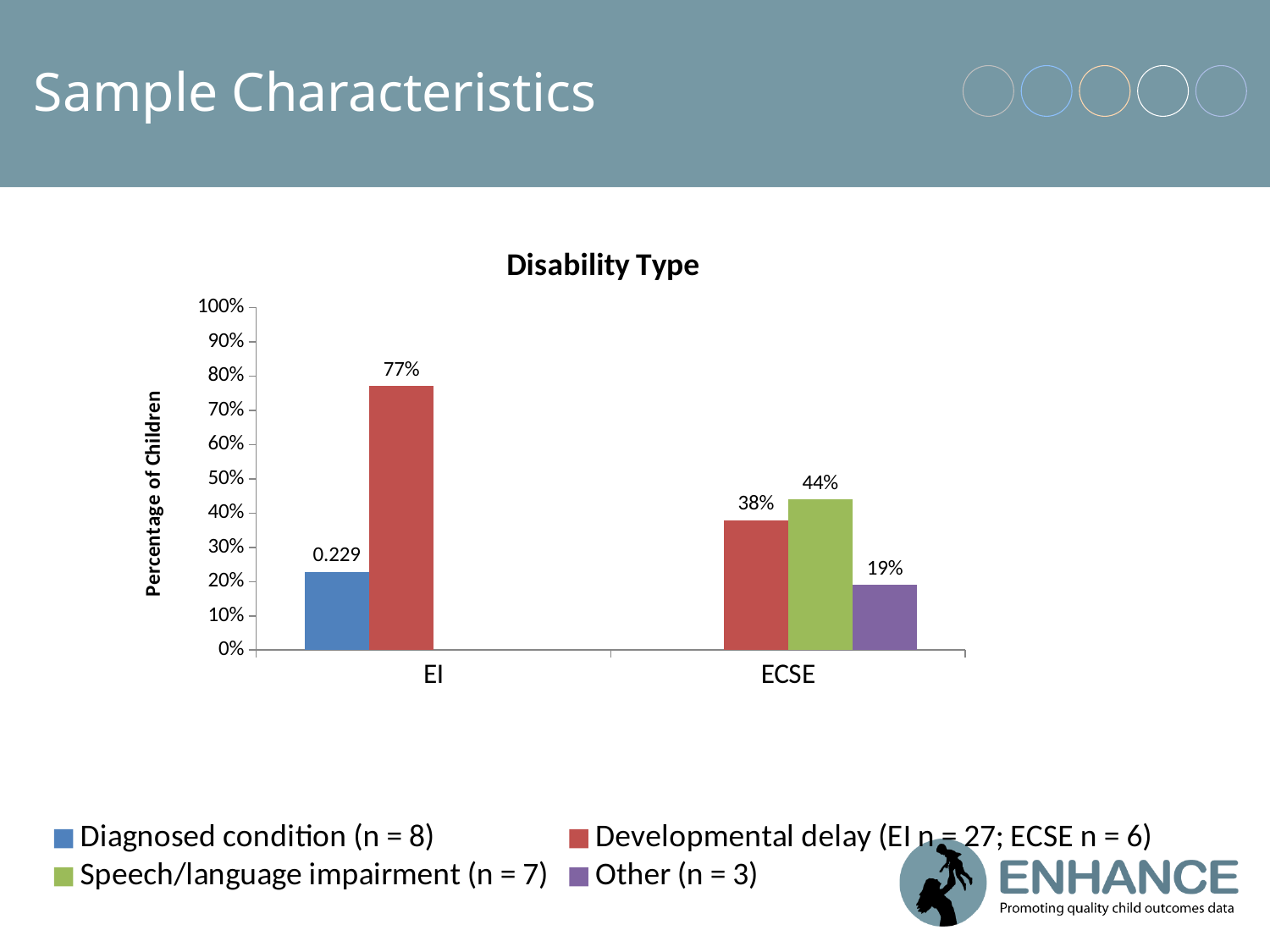
What is the difference between the Developmental delay percentage for EI and for ECSE? 39% What is the value for Speech/language impairment in the ECSE group? 44% What is the title of the chart? Disability Type What is the value for Developmental delay in the EI group? 77% What is the value for Developmental delay in the ECSE group? 38% What is the value for Other in the ECSE group? 19% Is the Developmental delay percentage larger for EI or for ECSE? EI Which disability type has the highest percentage in the ECSE group? Speech/language impairment Which disability type has the lowest percentage in the ECSE group? Other What type of chart is shown on the slide? bar chart What is the data label shown for Diagnosed condition in the EI group? 0.229 How many series does the legend list? 4